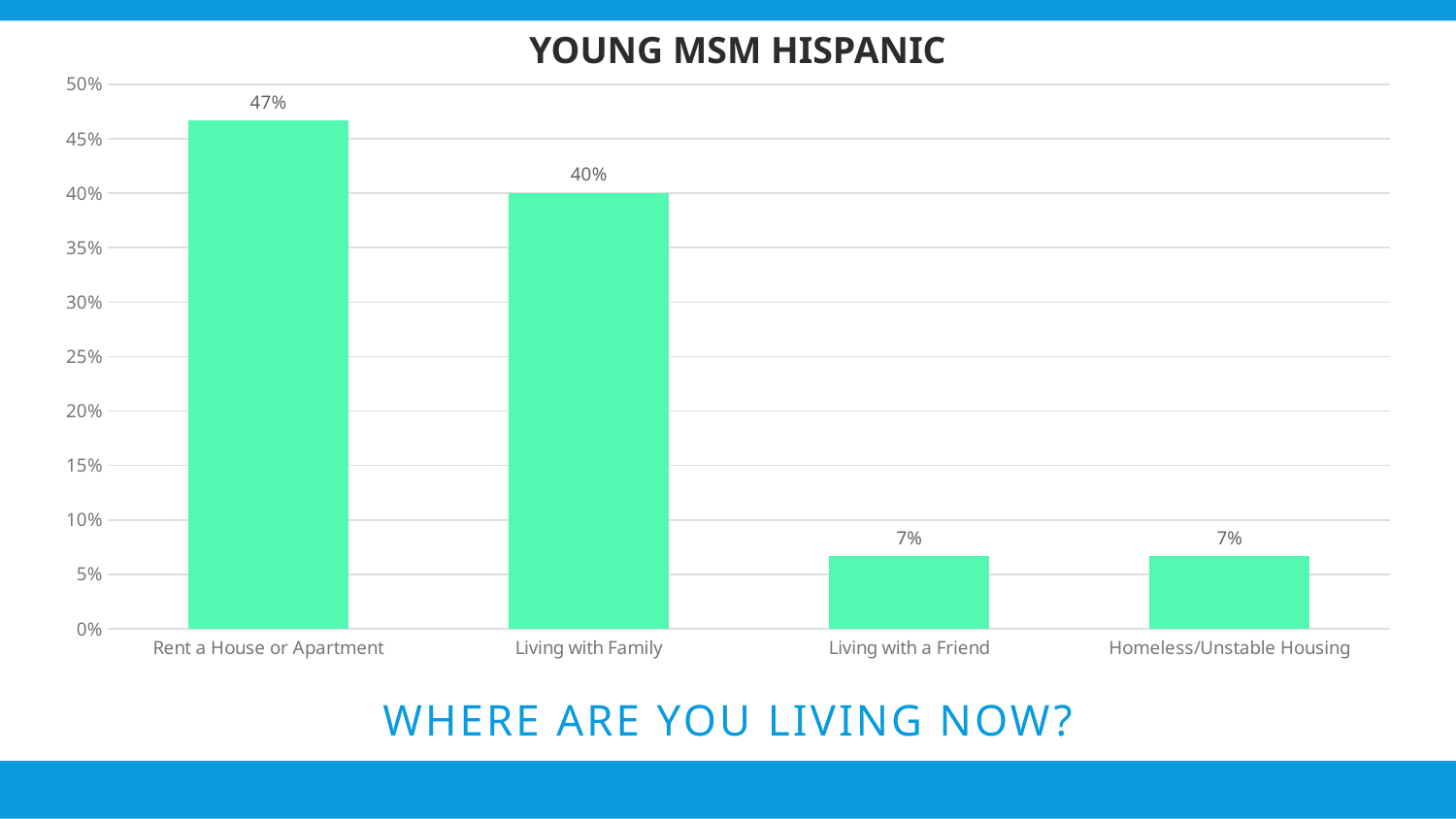
Which is larger, Rent a House or Apartment or Living with Family? Rent a House or Apartment What kind of chart is shown on the slide? Bar chart Is the value for Living with Family greater or less than 35%? greater What is the value for Living with a Friend? 7% What is the difference between Rent a House or Apartment and Living with Family? 7% How many categories are shown on the x axis? 4 What is the value for Living with Family? 40% What is the title of the chart? YOUNG MSM HISPANIC What is the difference between Living with Family and Living with a Friend? 33% What is the value for Homeless/Unstable Housing? 7% Which category has the highest value? Rent a House or Apartment What is the value for Rent a House or Apartment? 47%